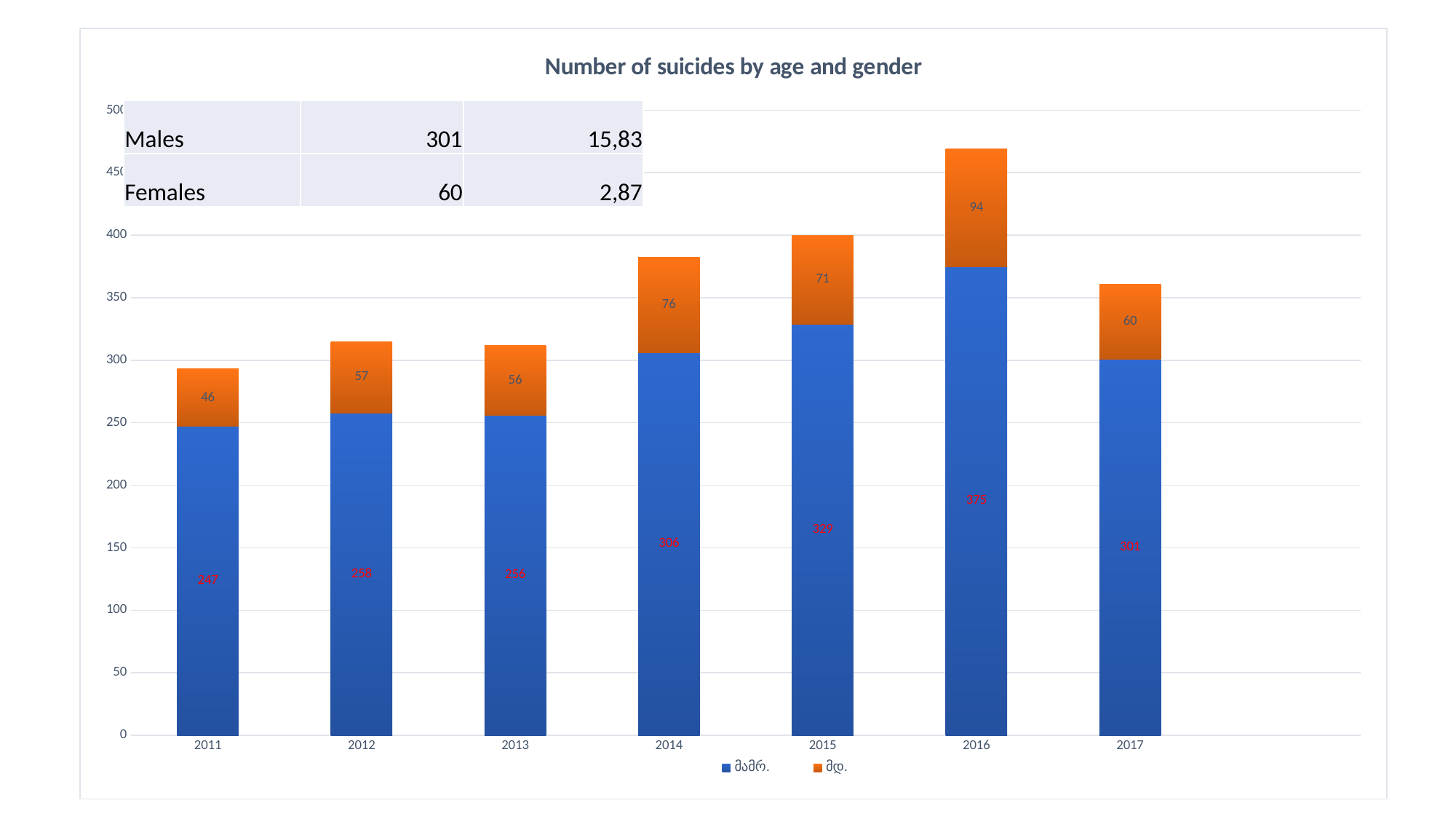
What type of chart is shown on the slide? stacked bar chart What is the difference between the blue (მამრ.) values for 2016 and 2017? 74 What is the total of the stacked bar for 2016? 469 Is the total stacked bar for 2011 greater or less than 300? less Which year has the lowest value for the orange (მდ.) series? 2011 Which is larger, the orange (მდ.) value for 2015 or for 2014? 2014 What is the value of the blue (მამრ.) segment for 2016? 375 What is the value of the orange (მდ.) segment for 2014? 76 What is the title of the chart? Number of suicides by age and gender Which year has the highest value for the blue (მამრ.) series? 2016 How many years are shown on the x axis? 7 How many series does the legend list? 2